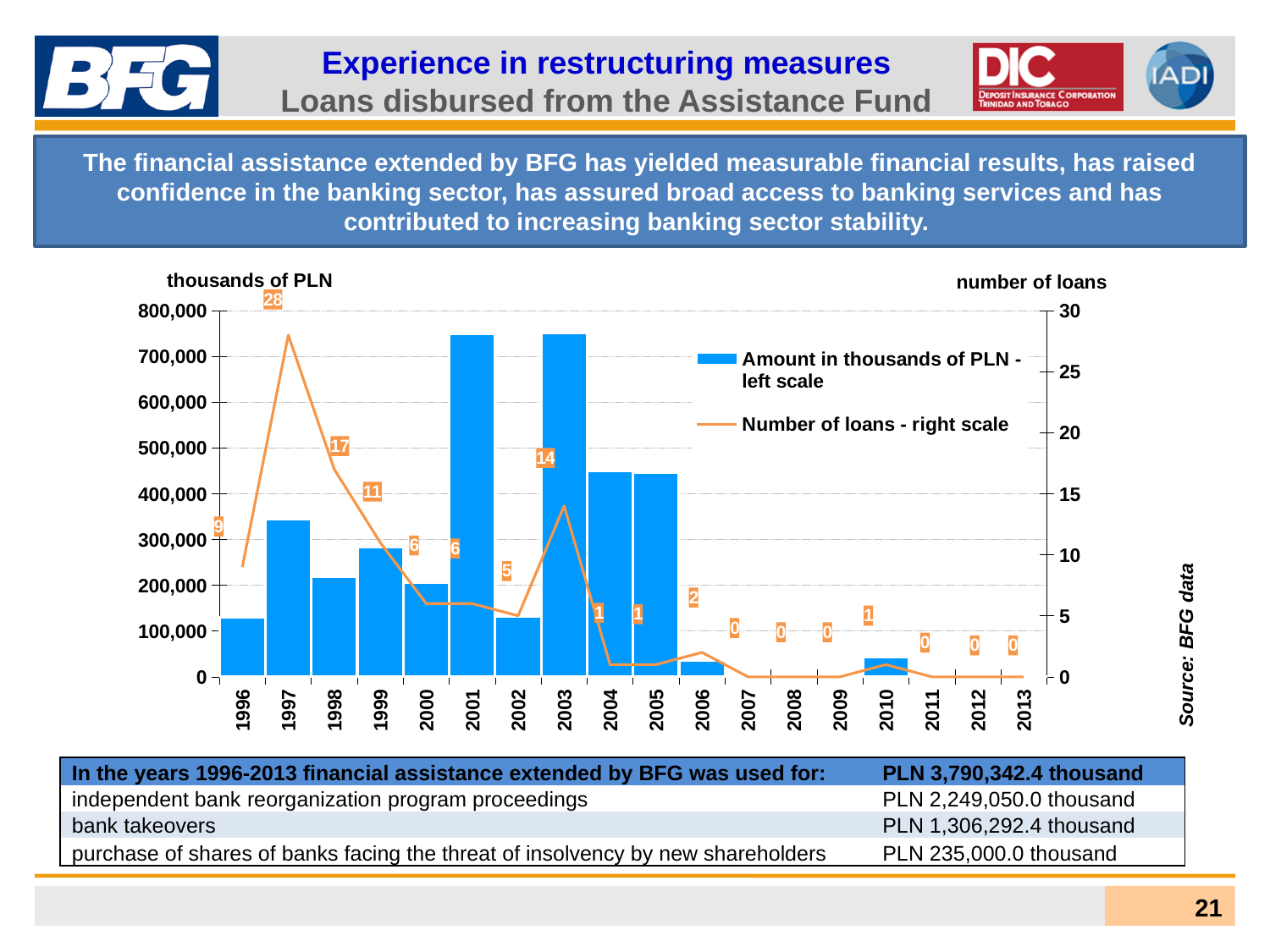
What was the number of loans in 2003? 14 How many years are shown on the x axis of the chart? 18 Is the amount in thousands of PLN for 2006 greater or less than 100,000? less What is the difference between the number of loans in 1997 and in 1998? 11 How many series does the chart legend list? 2 Does the number of loans rise or fall from 2003 to 2007? Fall Which year had more loans, 1998 or 1999? 1998 Is the amount in thousands of PLN for 2001 greater or less than 700,000? greater What was the number of loans in 1996? 9 In which year was the number of loans highest? 1997 What was the number of loans in 1997? 28 What kind of chart is shown on the slide? Combination bar and line chart